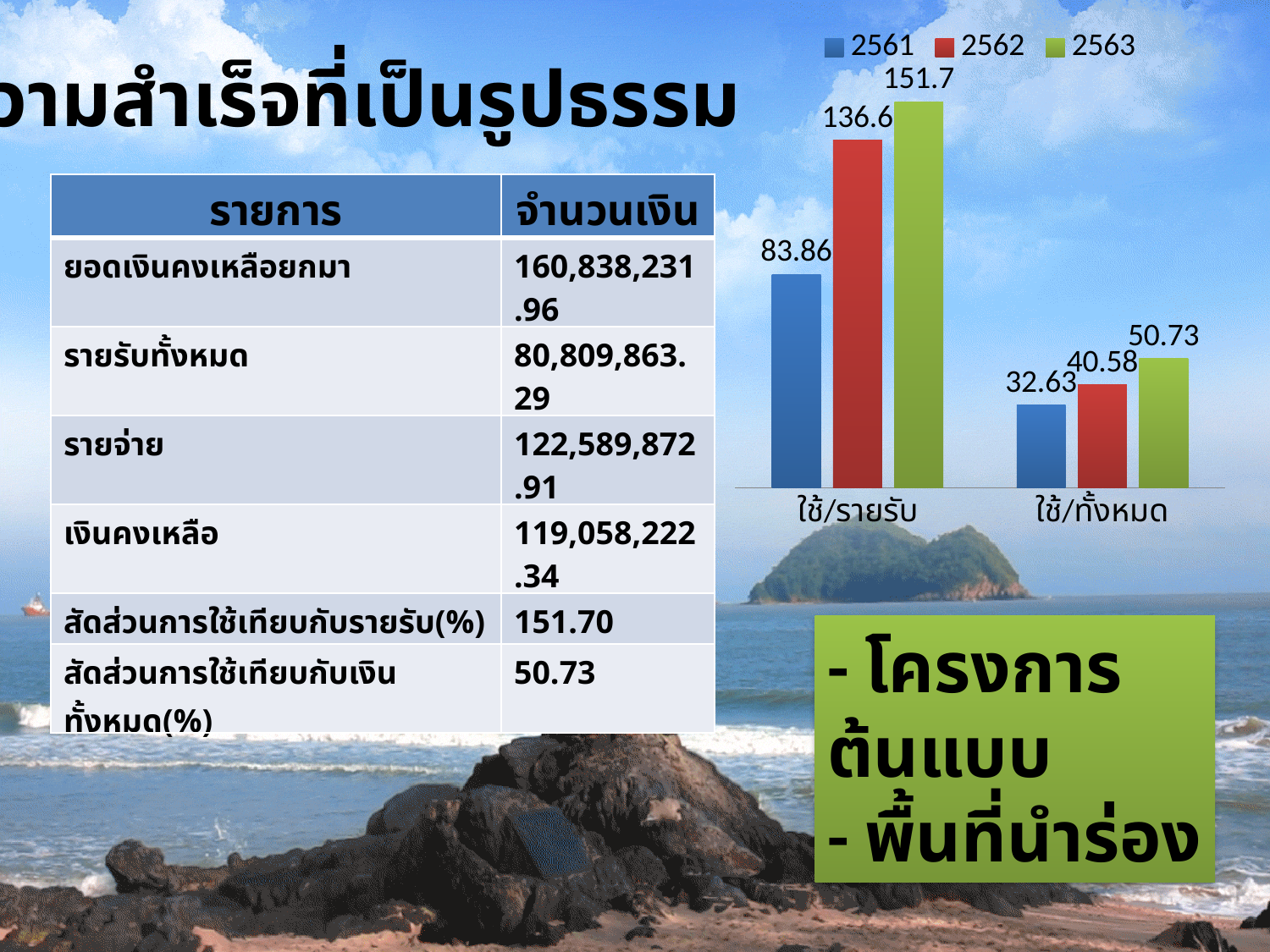
What kind of chart is shown on the slide? Bar chart What is the difference between the 2563 and 2561 values in the ใช้/รายรับ category? 67.84 Which series has the lowest value in the ใช้/ทั้งหมด category? 2561 Which is larger: the 2561 value for ใช้/รายรับ or the 2563 value for ใช้/ทั้งหมด? 2561 value for ใช้/รายรับ How many series does the legend list? 3 What is the value for 2561 in the ใช้/ทั้งหมด category? 32.63 What is the value for 2563 in the ใช้/รายรับ category? 151.7 What is the value for 2562 in the ใช้/ทั้งหมด category? 40.58 Do the values for the ใช้/ทั้งหมด category rise or fall from 2561 to 2563? Rise What is the value for 2562 in the ใช้/รายรับ category? 136.6 What is the difference between the 2563 and 2562 values in the ใช้/ทั้งหมด category? 10.15 Which series has the highest value in the ใช้/รายรับ category? 2563